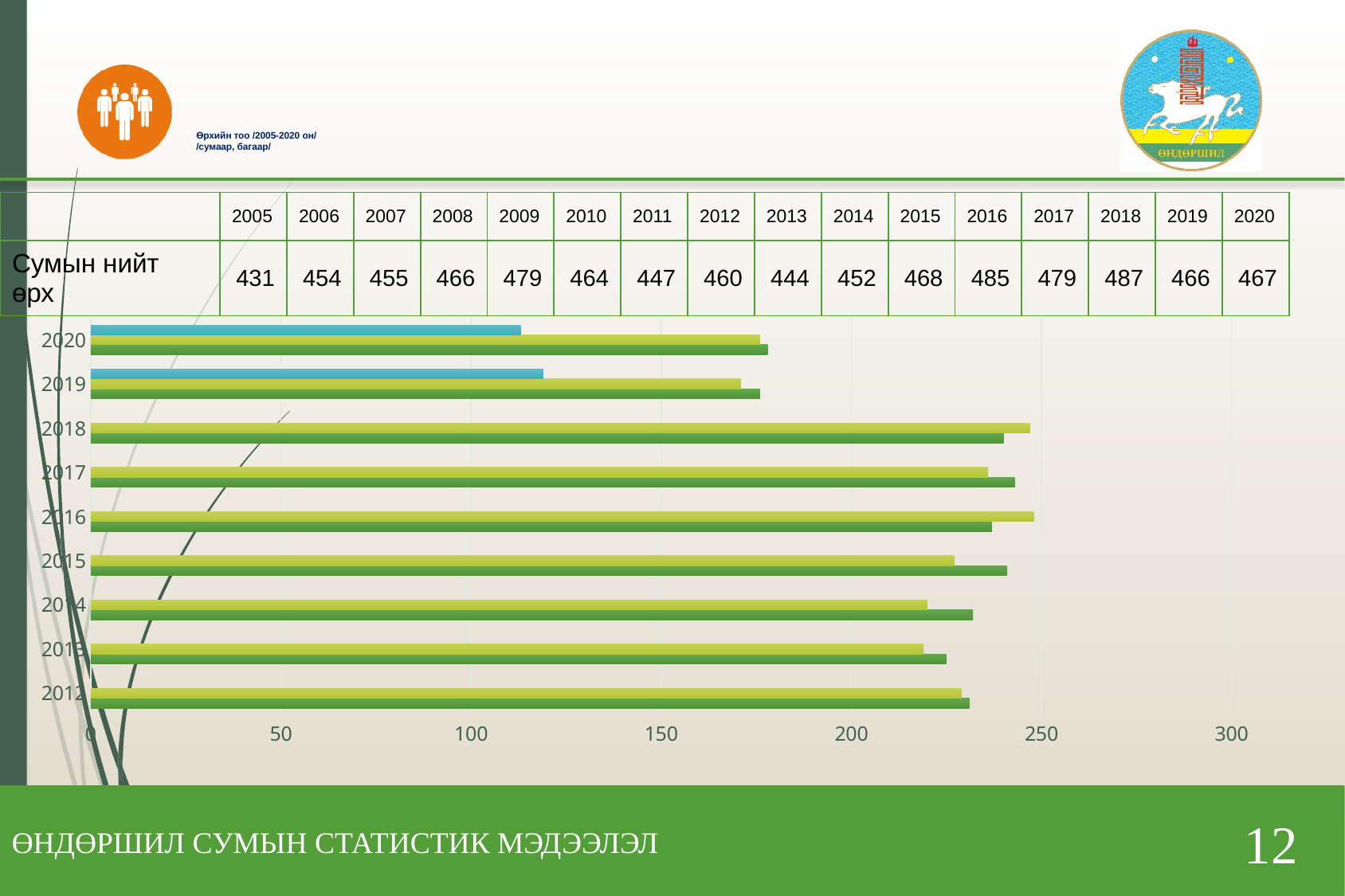
Is the value of the blue bar for 2019 greater or less than 100? greater Is the value of the light green bar for 2018 greater or less than 200? greater For 2020, which bar is longer: the blue bar or the light green bar? the light green bar Is the value of the light green bar for 2019 greater or less than 200? less Which year has the longer light green bar, 2018 or 2019? 2018 How many years are shown as categories on the bar chart's vertical axis? 9 What kind of chart is shown on the slide? bar chart What is the highest tick value shown on the bar chart's horizontal axis? 300 Which years are shown on the bar chart's vertical axis, from bottom to top? 2012 to 2020